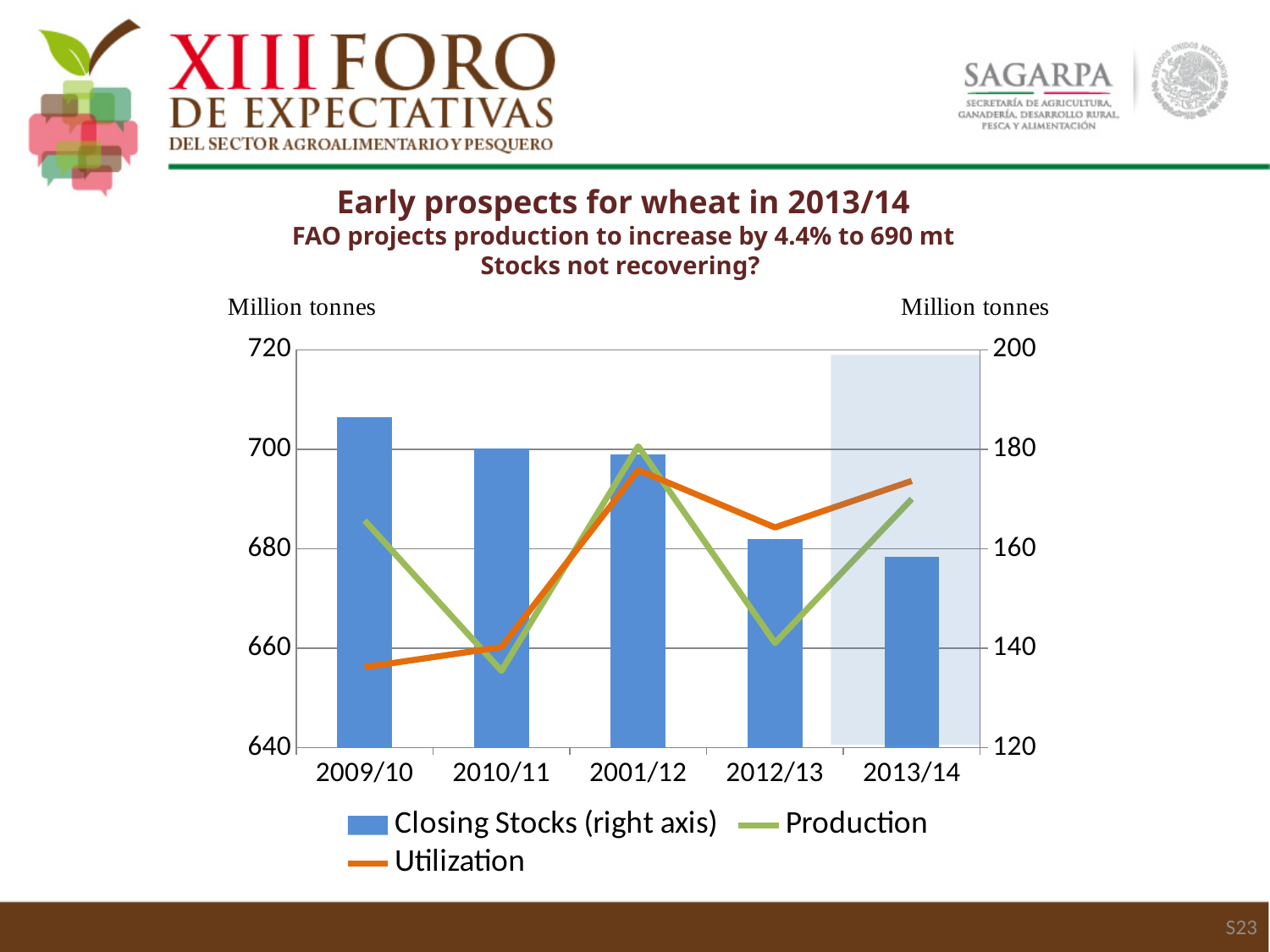
In which season are Closing Stocks highest? 2009/10 How many series does the legend list? 3 In which season are Closing Stocks lowest? 2013/14 In which season is Production lowest? 2010/11 In 2009/10, which is larger, Production or Utilization? Production How many seasons are shown on the x axis? 5 Is the value for Closing Stocks in 2009/10 greater or less than 180? greater Is the value for Production in 2010/11 greater or less than 660? less Does Utilization rise or fall from 2009/10 to 2001/12? Rise In which season is Production highest? 2001/12 Which series is plotted against the right axis? Closing Stocks What kind of chart is shown on the slide? A combined bar and line chart